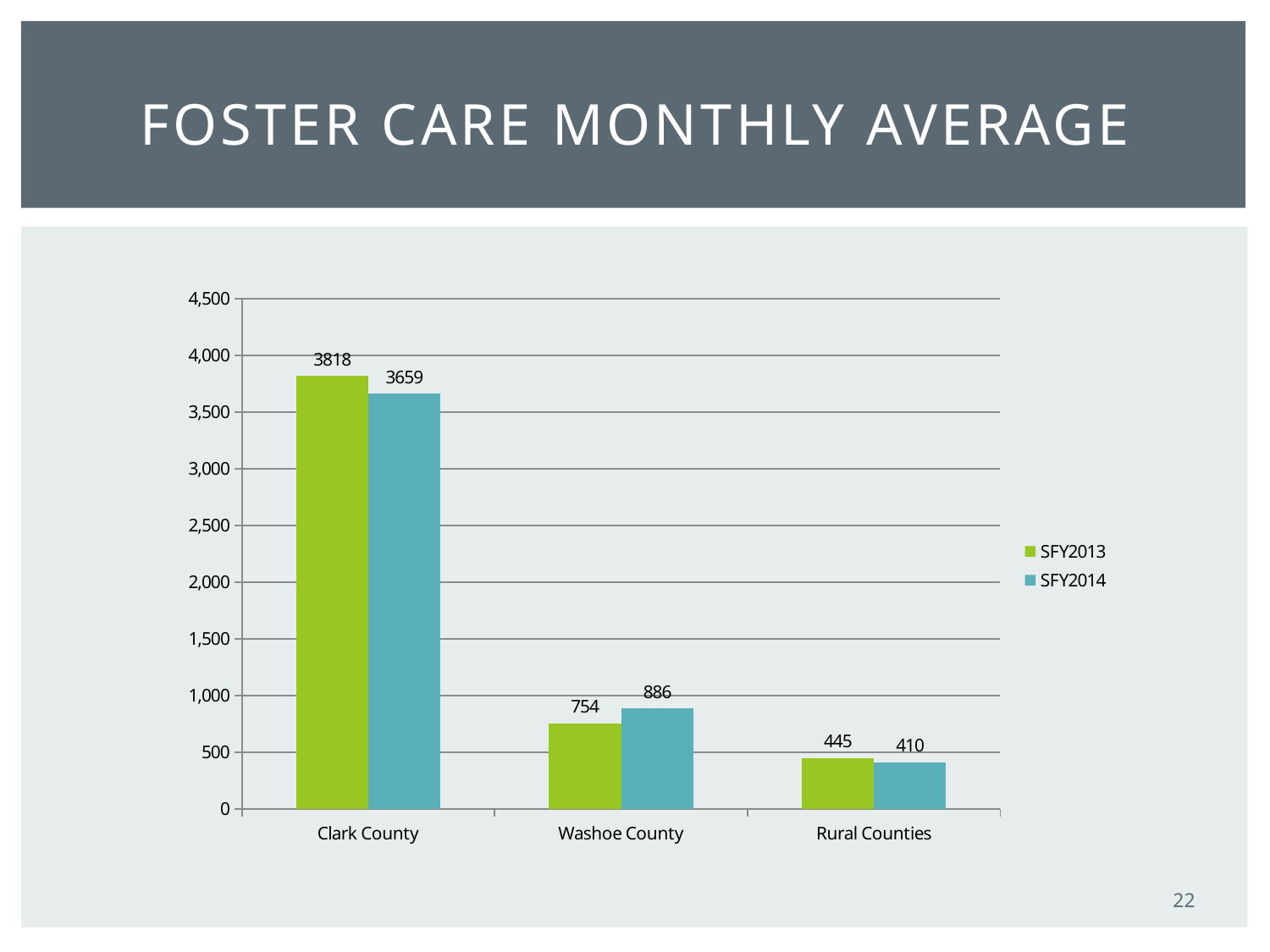
Is the SFY2013 value for Washoe County greater or less than 1,000? less Which category has the highest SFY2014 value? Clark County Which is larger for Rural Counties, the SFY2013 value or the SFY2014 value? SFY2013 What is the SFY2013 value for Clark County? 3818 What is the SFY2014 value for Rural Counties? 410 How many series does the legend list? 2 What is the difference between the SFY2014 and SFY2013 values for Washoe County? 132 What is the difference between the SFY2013 and SFY2014 values for Clark County? 159 How many categories are shown on the x axis? 3 What kind of chart is shown on the slide? bar chart Which category has the lowest SFY2013 value? Rural Counties What is the SFY2014 value for Washoe County? 886